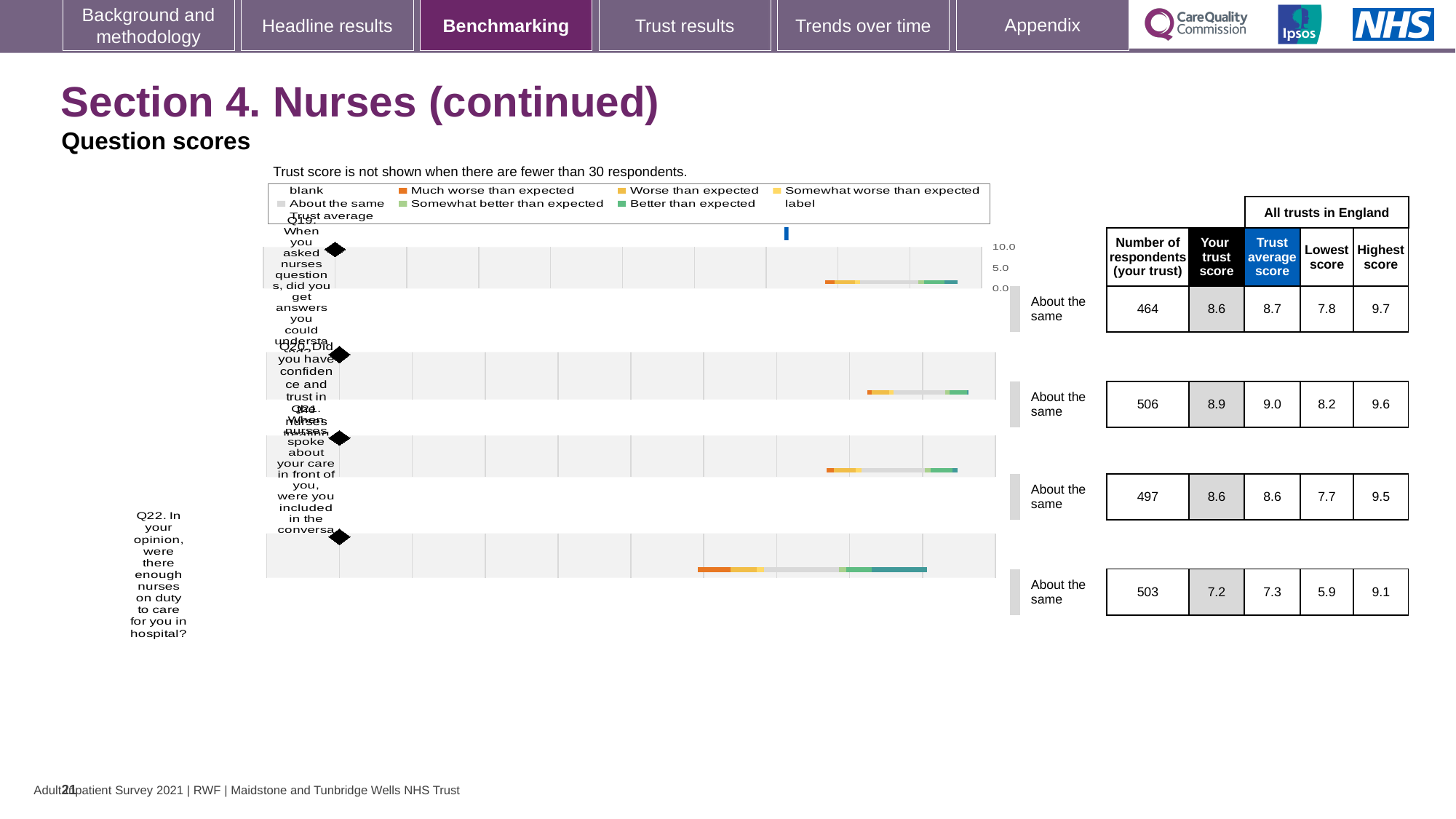
Which question has the highest trust score? Q20 What is the trust average score across all trusts in England for Q21? 8.6 How many respondents from the trust answered Q20 (confidence and trust in the nurses)? 506 What is the difference between the highest score and the lowest score for Q22? 3.2 What is the trust score for Q22 (were there enough nurses on duty to care for you in hospital)? 7.2 What is the difference between the trust score for Q20 and the trust score for Q22? 1.7 How many questions are plotted on the chart? 4 What is the highest score among all trusts in England for Q22? 9.1 Is the trust score for Q22 greater or less than 5.0? greater Which question has the lowest trust score? Q22 What benchmark category is shown for Q19? About the same Which has the larger trust score, Q20 or Q19? Q20